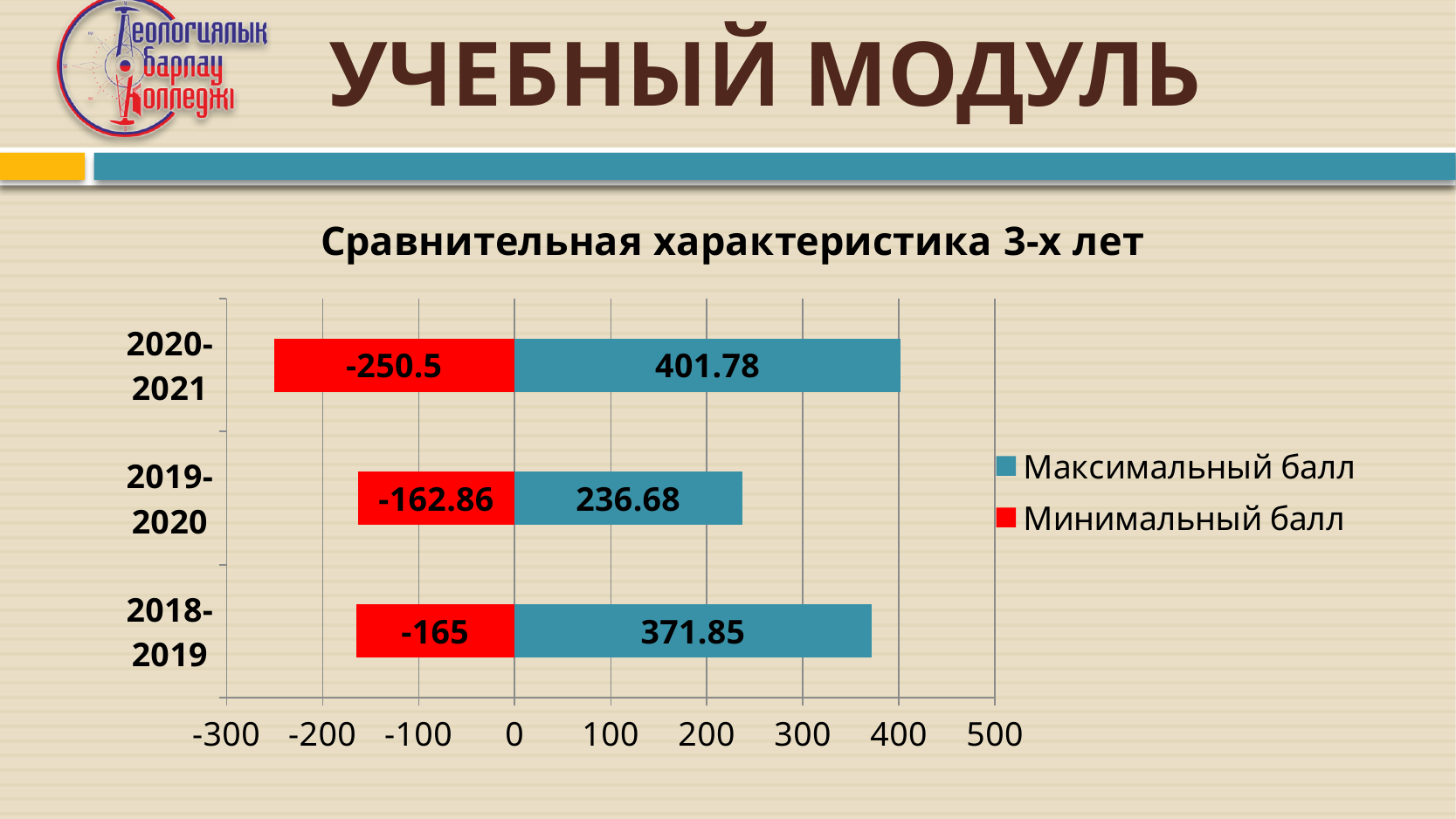
Is the Максимальный балл for 2020-2021 greater or less than 400? greater What is the difference between the Максимальный балл for 2020-2021 and 2019-2020? 165.1 What is the value of Максимальный балл for 2018-2019? 371.85 What is the value of Минимальный балл for 2019-2020? -162.86 Which year has the highest Максимальный балл? 2020-2021 How many year categories are shown on the chart? 3 Which is larger: the Максимальный балл for 2018-2019 or for 2019-2020? 2018-2019 Which year has the lowest Максимальный балл? 2019-2020 What is the value of Максимальный балл for 2020-2021? 401.78 How many series does the legend list? 2 What is the value of Минимальный балл for 2020-2021? -250.5 What type of chart is shown on the slide? Bar chart